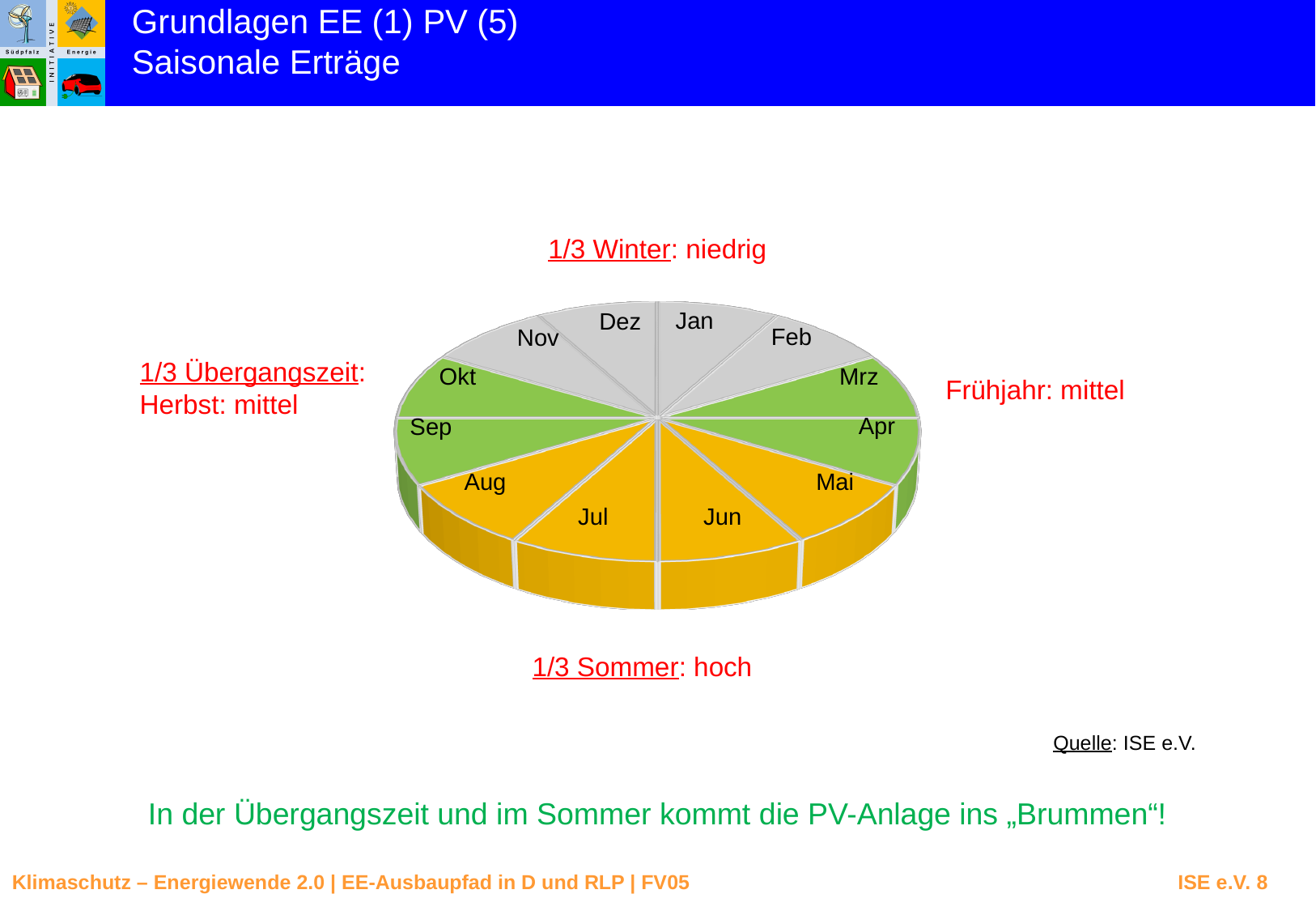
What yield level does the slide assign to Frühjahr? mittel How many slices does the pie chart have? 12 Which months of the pie chart are coloured grey? Nov, Dez, Jan, Feb According to the slide, what share of the year does the Sommer group of months represent? 1/3 What kind of chart is shown on the slide? pie chart What yield level does the slide assign to the Sommer slices of the pie chart? hoch Which months of the pie chart are coloured yellow/orange? Mai, Jun, Jul, Aug According to the slide, what share of the year does the Winter group of months represent? 1/3 What yield level does the slide assign to the Winter slices of the pie chart? niedrig